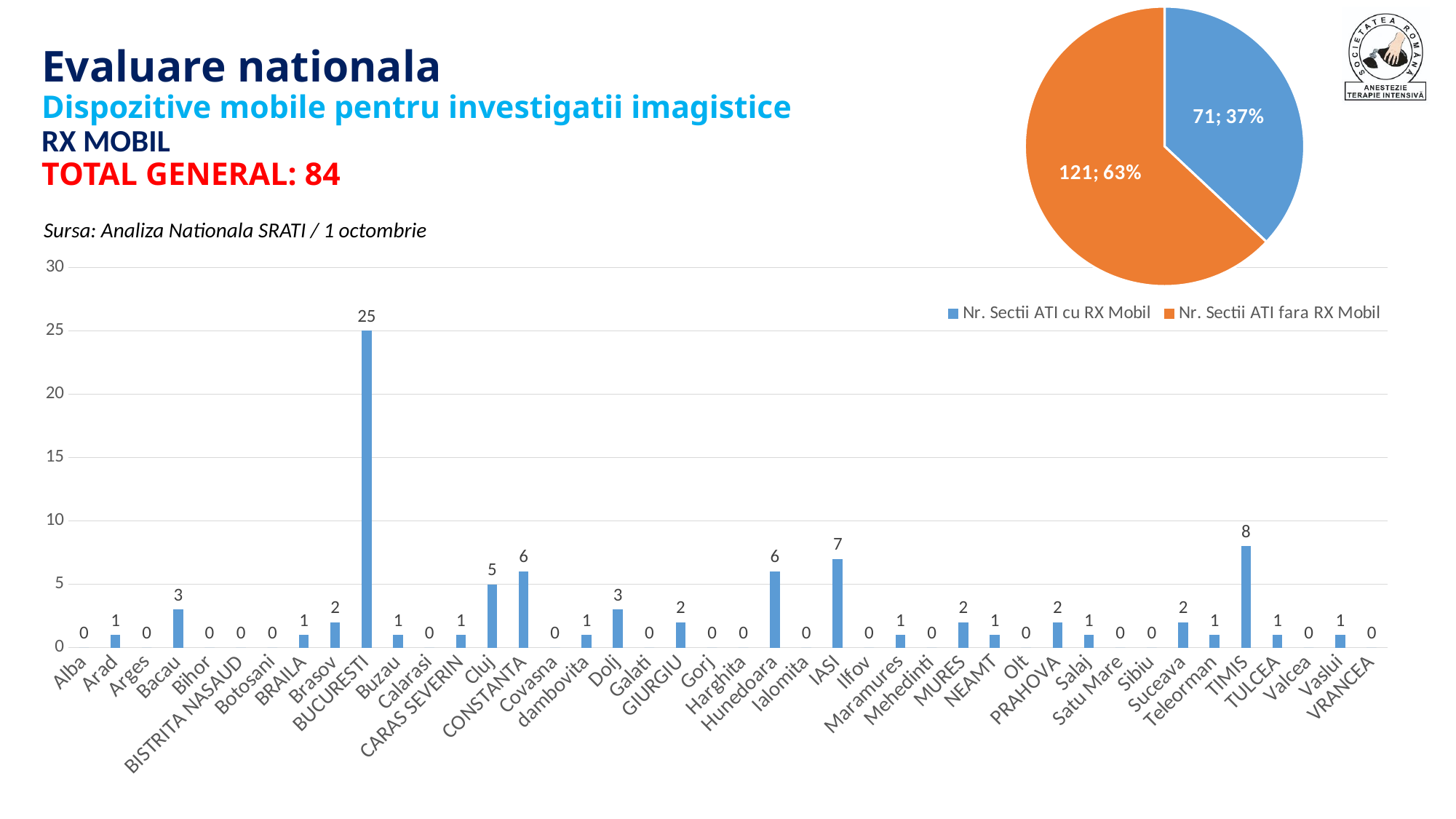
In the bar chart, what is the value for BUCURESTI? 25 In the bar chart, is the value for BUCURESTI greater or less than 20? greater In the bar chart, what is the difference between the values for BUCURESTI and TIMIS? 17 How many entries does the legend of the pie chart list? 2 In the pie chart, what value and percentage are shown for the orange slice (Nr. Sectii ATI fara RX Mobil)? 121; 63% In the bar chart, which county has the highest value? BUCURESTI How many counties are shown on the x axis of the bar chart? 42 In the pie chart, what share does the blue slice (Nr. Sectii ATI cu RX Mobil) represent? 37% In the bar chart, what is the value for TIMIS? 8 What kind of chart is the chart at the bottom of the slide? bar chart In the bar chart, what is the value for IASI? 7 In the bar chart, which is larger, the value for Cluj or the value for CONSTANTA? CONSTANTA